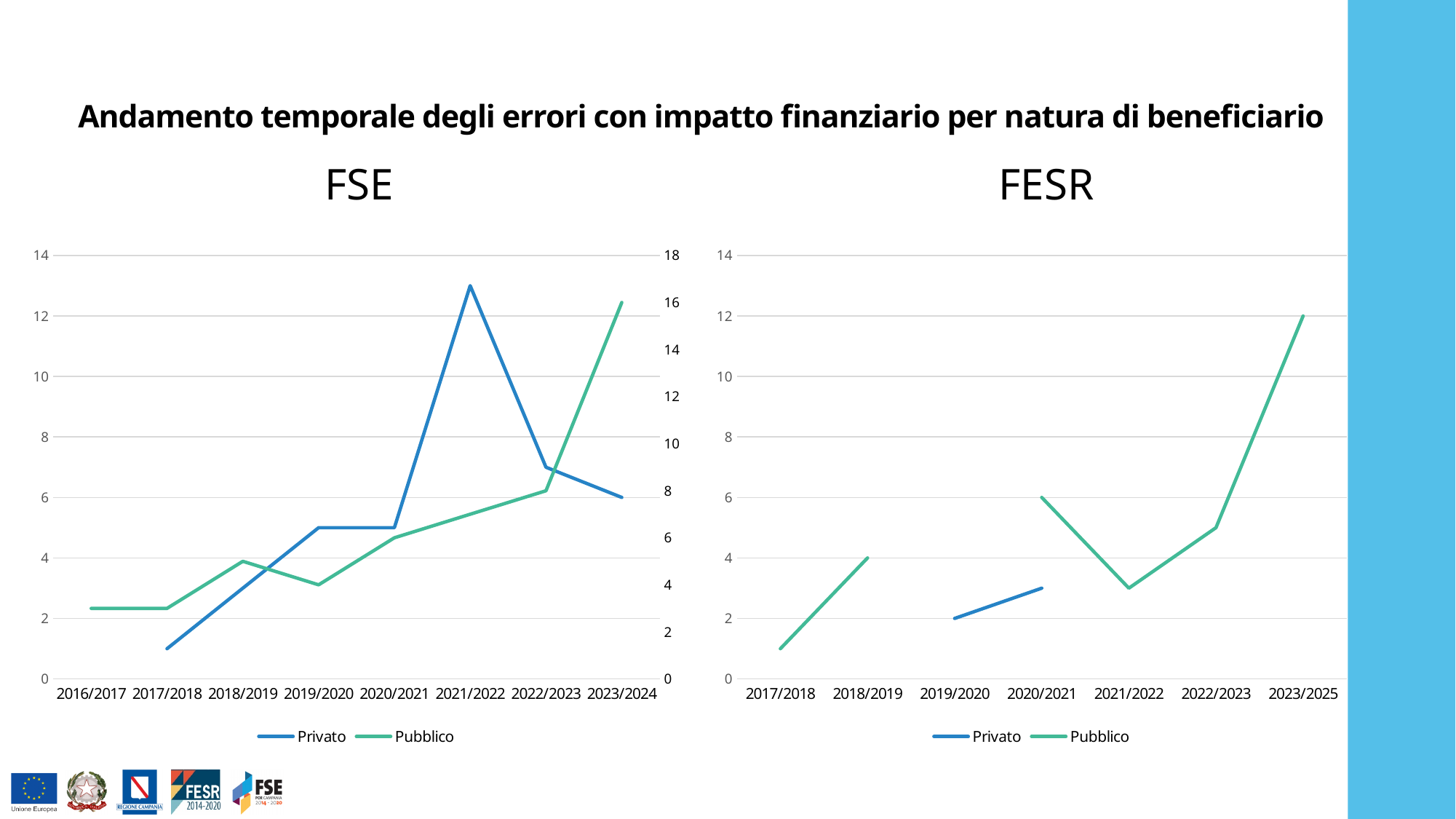
How many series does the legend of the FESR chart list? 2 In the FSE chart, in which period does Privato reach its peak? 2021/2022 In the FESR chart, in which period is the Pubblico value lowest? 2017/2018 In the FESR chart, in which period does Pubblico reach its highest value? 2023/2025 In the FSE chart, is the value for Privato in 2021/2022 greater or less than 12? greater In the FESR chart, what is the value for Privato in 2019/2020? 2 What type of chart is the FSE chart? line chart In the FESR chart, what is the value for Pubblico in 2023/2025? 12 How many periods are shown on the x axis of the FSE chart? 8